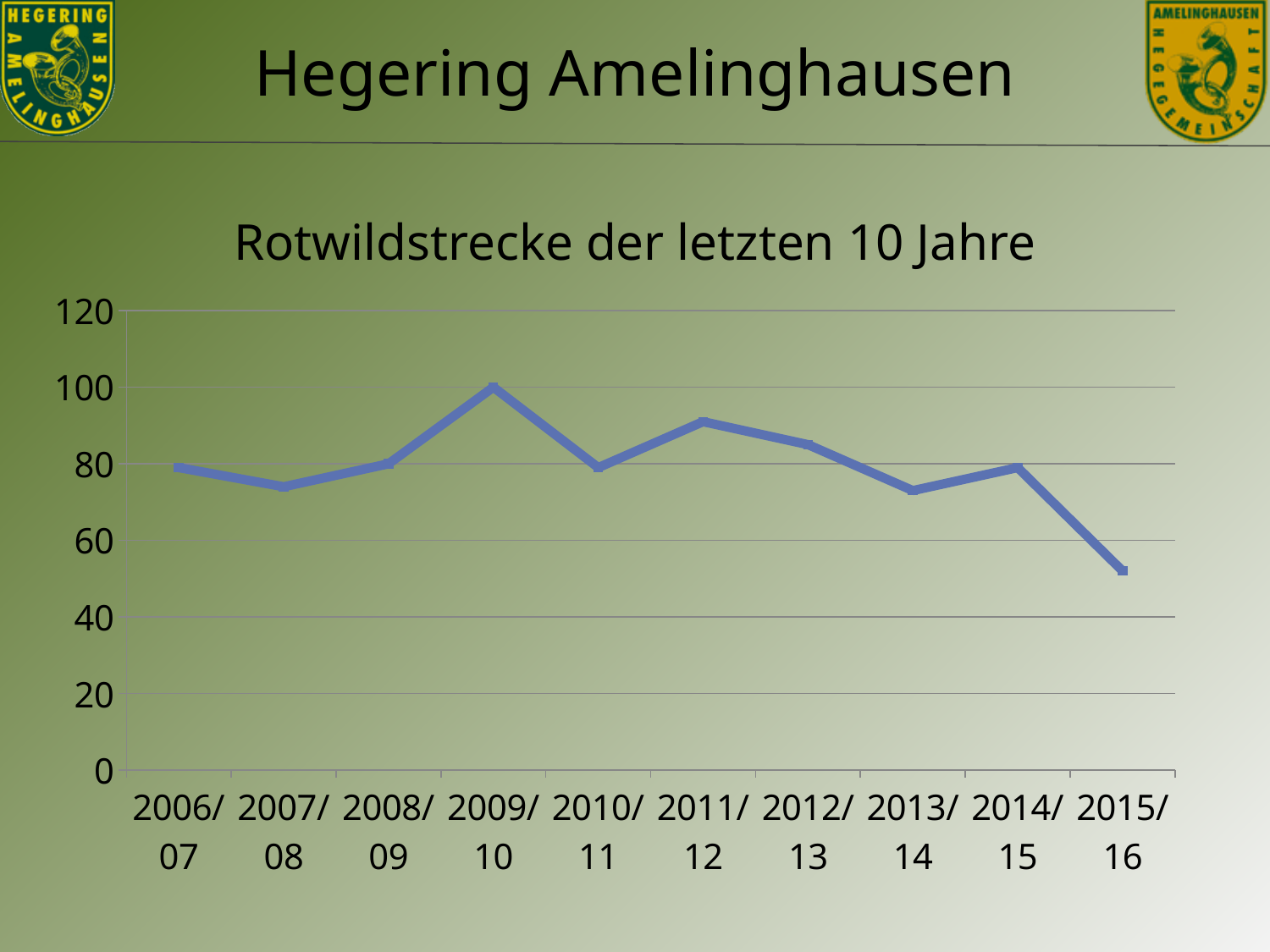
Is the value for 2011/12 greater or less than 80? greater Which season has the lowest value on the chart? 2015/16 Is the value for 2007/08 greater or less than 80? less Which is larger, the value for 2011/12 or the value for 2013/14? 2011/12 What is the title of the chart? Rotwildstrecke der letzten 10 Jahre What is the value for 2009/10? 100 What type of chart is shown on the slide? line chart Do the values rise or fall from 2009/10 to 2015/16? fall How many seasons (x-axis categories) are plotted on the chart? 10 Is the value for 2015/16 greater or less than 60? less Which season has the highest value on the chart? 2009/10